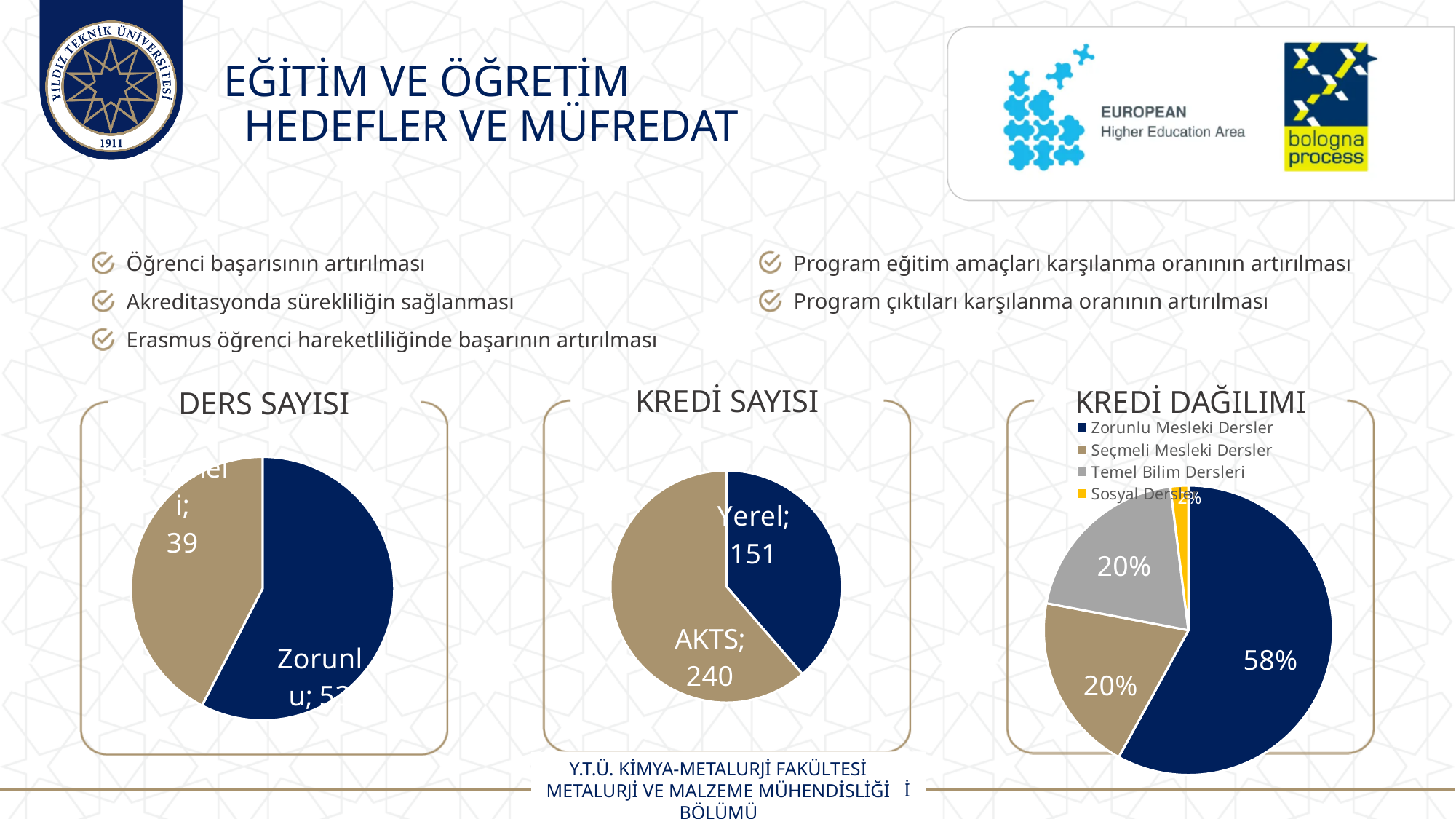
In the KREDİ DAĞILIMI chart, what share of the pie is Sosyal Dersler? 2% In the KREDİ SAYISI chart, what is the value for Yerel? 151 How many slices does the DERS SAYISI pie chart have? 2 In the KREDİ SAYISI chart, what is the difference between the AKTS and Yerel values? 89 What kind of chart is the DERS SAYISI chart? Pie chart In the KREDİ DAĞILIMI chart, what is the difference in percentage points between Zorunlu Mesleki Dersler and Temel Bilim Dersleri? 38 In the KREDİ SAYISI chart, what is the value for AKTS? 240 In the KREDİ DAĞILIMI chart, which category has the smallest share? Sosyal Dersler In the KREDİ SAYISI chart, which category has the larger value, Yerel or AKTS? AKTS In the KREDİ DAĞILIMI chart, what share of the pie is Zorunlu Mesleki Dersler? 58% In the KREDİ DAĞILIMI chart, how many entries does the legend list? 4 In the KREDİ DAĞILIMI chart, which category has the largest share? Zorunlu Mesleki Dersler